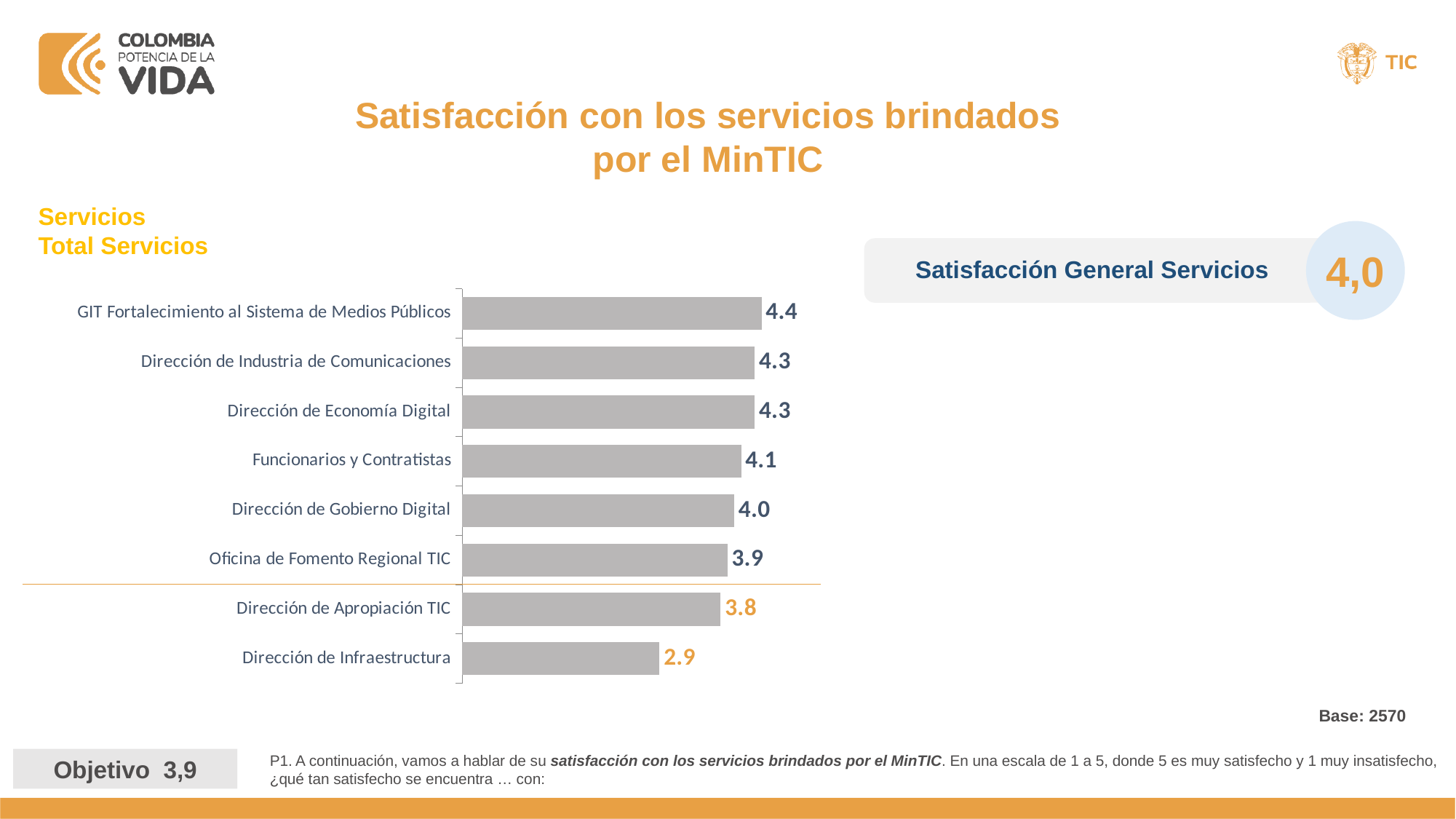
Which category has the highest satisfaction value? GIT Fortalecimiento al Sistema de Medios Públicos What is the satisfaction value for Oficina de Fomento Regional TIC? 3.9 What is the Objetivo value shown at the bottom of the slide? 3,9 What is the difference between the values for GIT Fortalecimiento al Sistema de Medios Públicos and Dirección de Infraestructura? 1.5 Which has a higher value, Funcionarios y Contratistas or Dirección de Apropiación TIC? Funcionarios y Contratistas What is the satisfaction value for Dirección de Infraestructura? 2.9 What is the satisfaction value for Funcionarios y Contratistas? 4.1 What kind of chart is shown on the slide? Bar chart Which category has the lowest satisfaction value? Dirección de Infraestructura What is the Satisfacción General Servicios value shown on the slide? 4,0 How many categories are shown in the bar chart? 8 What is the difference between the values for Dirección de Gobierno Digital and Dirección de Apropiación TIC? 0.2